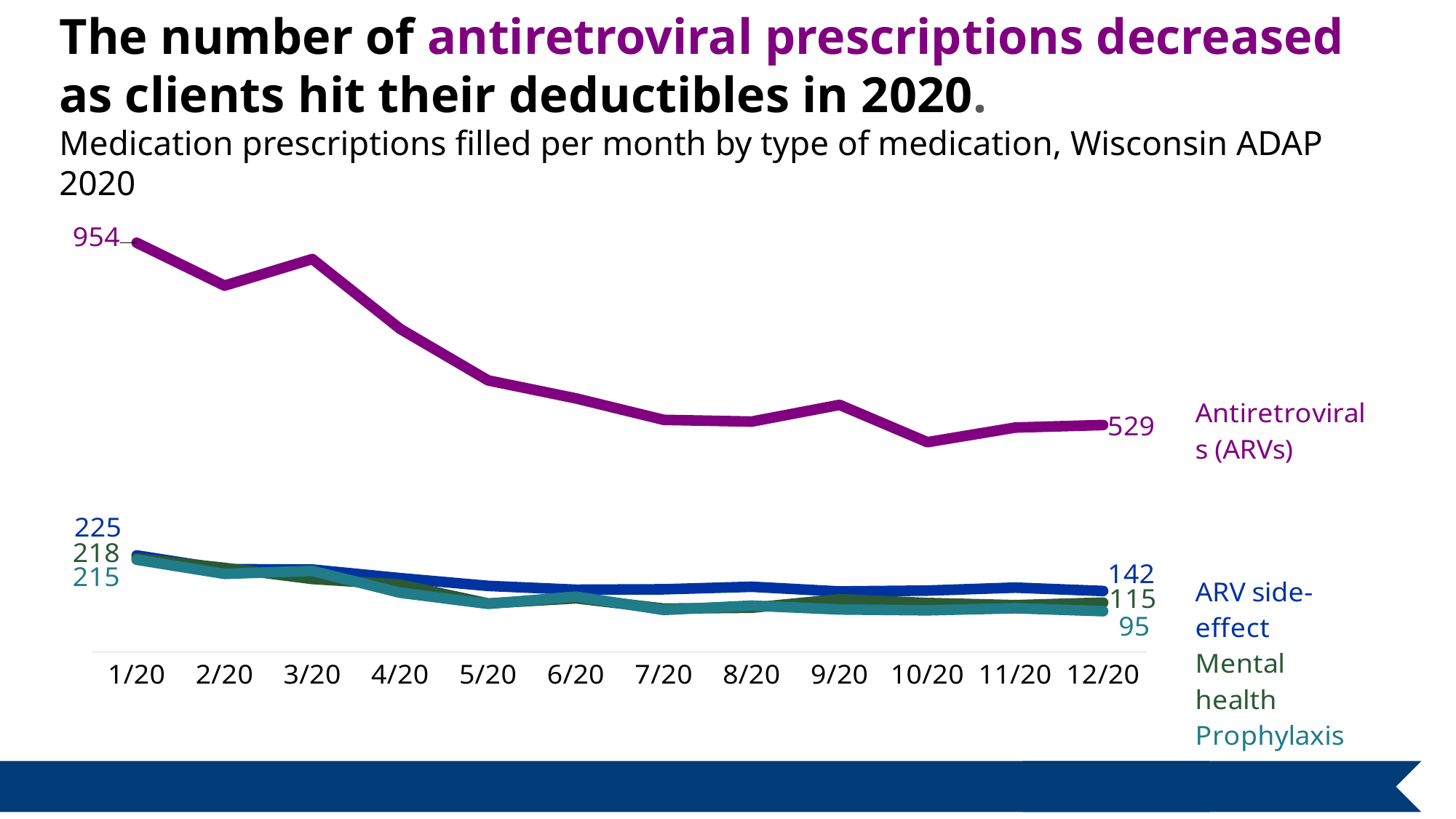
What was the number of mental health prescriptions filled in 12/20? 115 Which medication type had the lowest number of prescriptions filled in 12/20? Prophylaxis Which medication type had the highest number of prescriptions filled in 12/20? Antiretrovirals (ARVs) How many medication types (series) are plotted in the chart? 4 What was the number of prophylaxis prescriptions filled in 12/20? 95 By how much did antiretroviral (ARV) prescriptions decrease from 1/20 to 12/20? 425 What was the number of antiretroviral (ARV) prescriptions filled in 1/20? 954 What type of chart is shown on the slide? line chart What was the number of antiretroviral (ARV) prescriptions filled in 12/20? 529 Did the number of antiretroviral (ARV) prescriptions rise or fall over the course of 2020? fall What was the number of ARV side-effect prescriptions filled in 1/20? 225 How many months are plotted along the x axis? 12